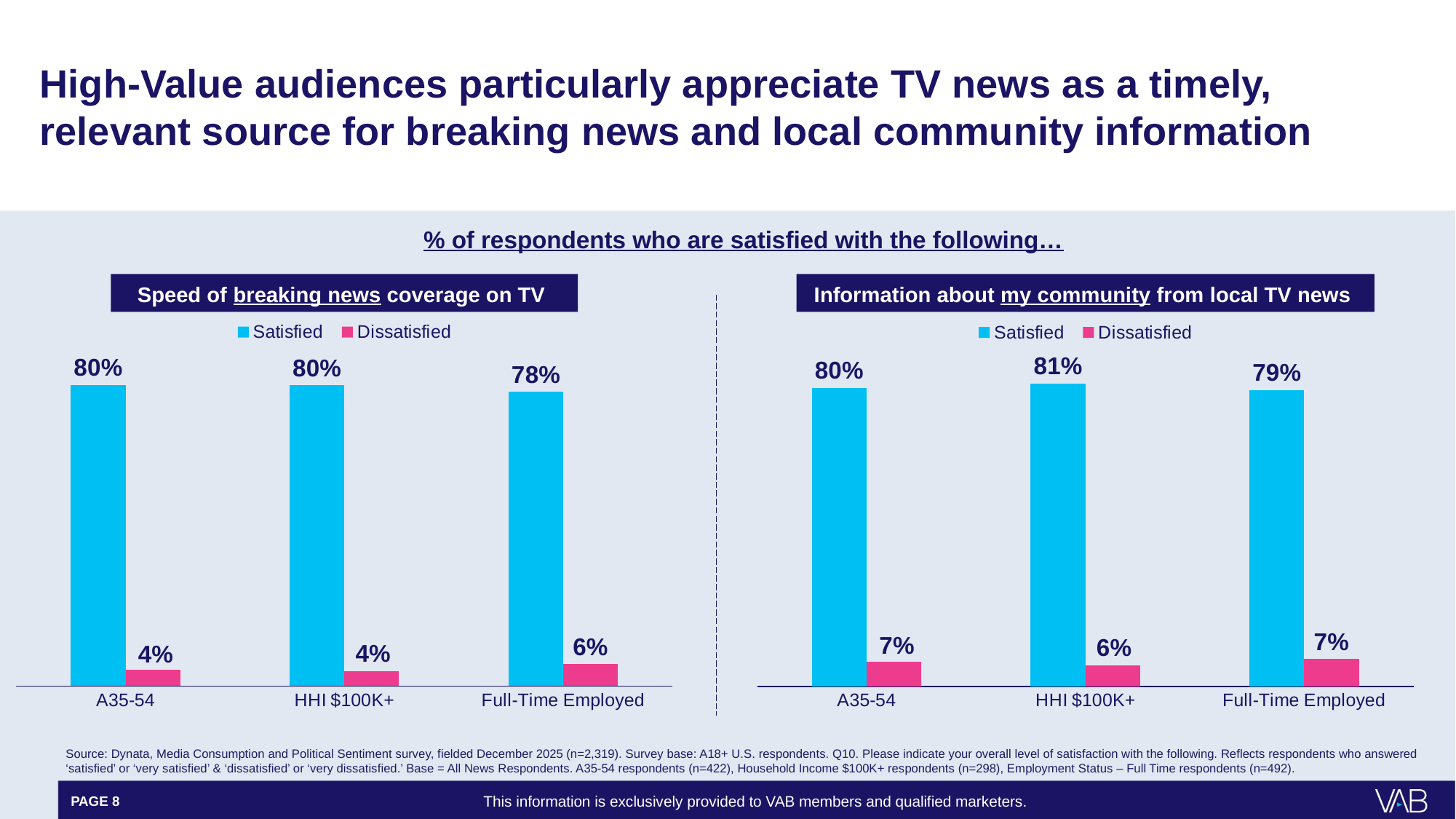
What kind of chart is the 'Speed of breaking news coverage on TV' chart? Bar chart In the 'Speed of breaking news coverage on TV' chart, what is the difference between the Satisfied and Dissatisfied values for HHI $100K+? 76% In the 'Speed of breaking news coverage on TV' chart, what is the Satisfied value for A35-54? 80% In the 'Speed of breaking news coverage on TV' chart, what is the Dissatisfied value for Full-Time Employed? 6% In the 'Information about my community from local TV news' chart, what is the difference between the Satisfied values for HHI $100K+ and Full-Time Employed? 2% How many categories are shown on the x axis of the 'Speed of breaking news coverage on TV' chart? 3 In the 'Speed of breaking news coverage on TV' chart, which category has the lowest Satisfied value? Full-Time Employed In the 'Information about my community from local TV news' chart, what is the Dissatisfied value for A35-54? 7% In the 'Information about my community from local TV news' chart, which category has the highest Satisfied value? HHI $100K+ In the 'Information about my community from local TV news' chart, what is the Satisfied value for HHI $100K+? 81% Is the Dissatisfied value for Full-Time Employed larger in the 'Speed of breaking news coverage on TV' chart or in the 'Information about my community from local TV news' chart? Information about my community from local TV news How many series does the legend of the 'Information about my community from local TV news' chart list? 2